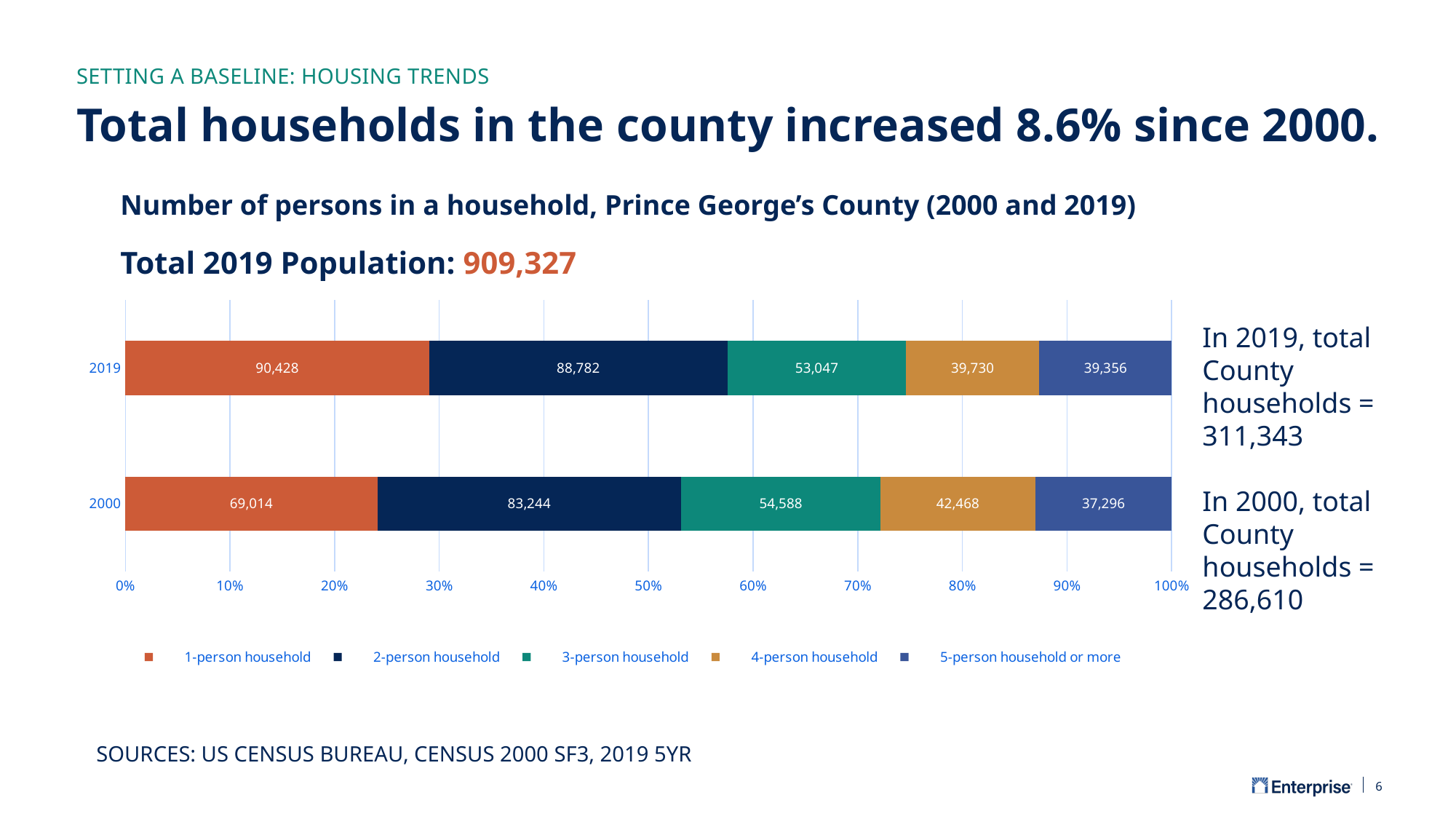
What is the total of the 2019 stacked bar? 311,343 Which household size category has the largest value in the 2019 bar? 1-person household How many series does the legend list? 5 Which household size category has the smallest value in the 2000 bar? 5-person household or more What is the value for 5-person household or more in 2019? 39,356 What kind of chart is shown on the slide? Stacked bar chart What is the difference between the 1-person household values for 2019 and 2000? 21,414 What is the value for 2-person households in 2000? 83,244 Which household size category has the largest value in the 2000 bar? 2-person household Which is larger: the 3-person household value in 2000 or in 2019? 2000 What is the value for 1-person households in 2019? 90,428 How many bars (years) are shown in the chart? 2